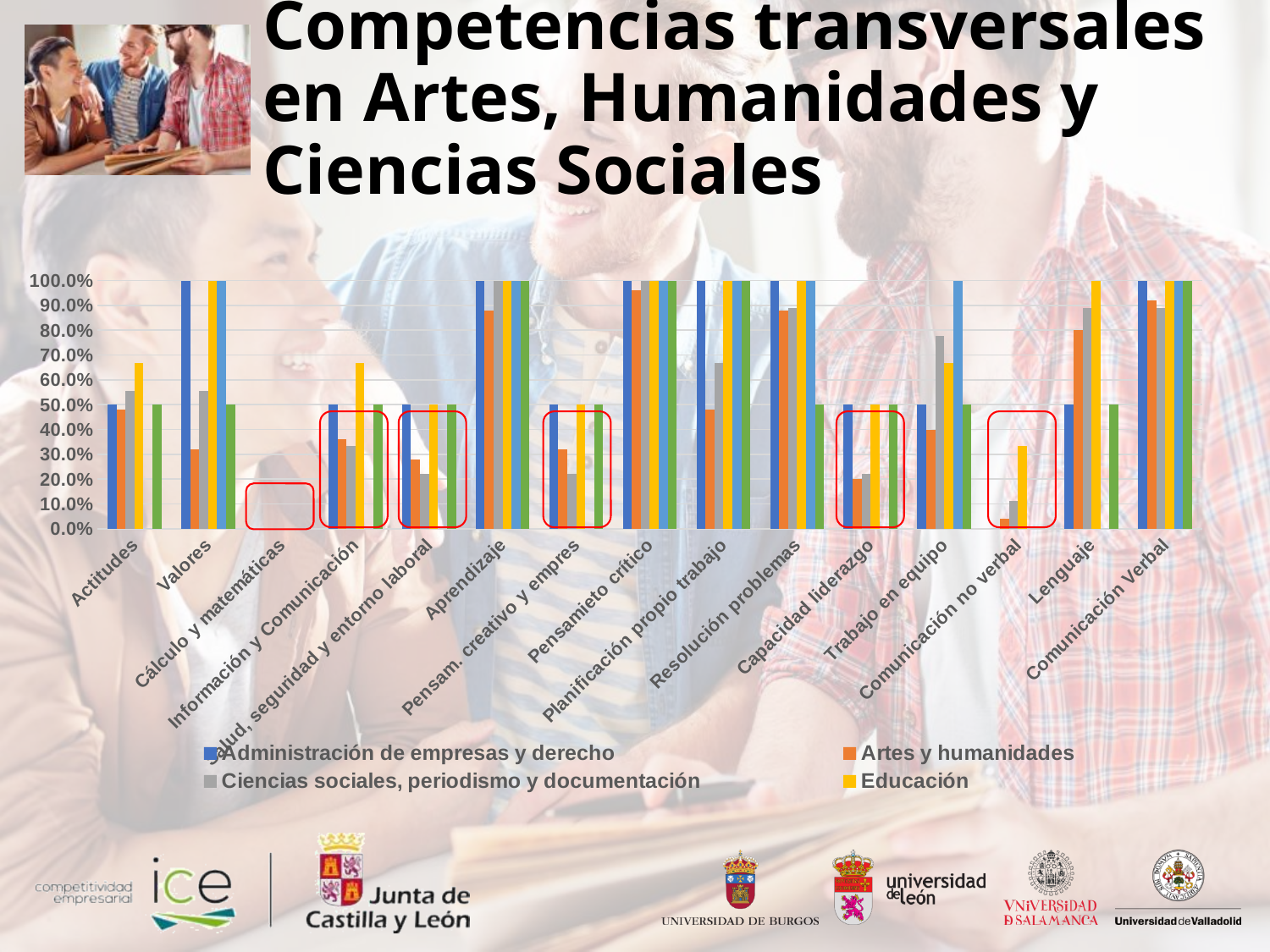
In the Actitudes category, which is larger: the value for Educación or the value for Artes y humanidades? Educación Is the value for Artes y humanidades in the Valores category greater or less than 40%? less Is the value for Artes y humanidades in the Comunicación no verbal category greater or less than 10%? less Is the value for Educación in the Actitudes category greater or less than 60%? greater How many series does the chart's legend list? 4 Which series has the highest value in the Comunicación no verbal category? Educación What colour represents the Educación series in the chart? yellow Which series has the lowest value in the Comunicación no verbal category? Administración de empresas y derecho What kind of chart is shown on the slide? bar chart What is the value for Administración de empresas y derecho in the Valores category? 100.0% How many competency categories are shown along the x axis of the chart? 15